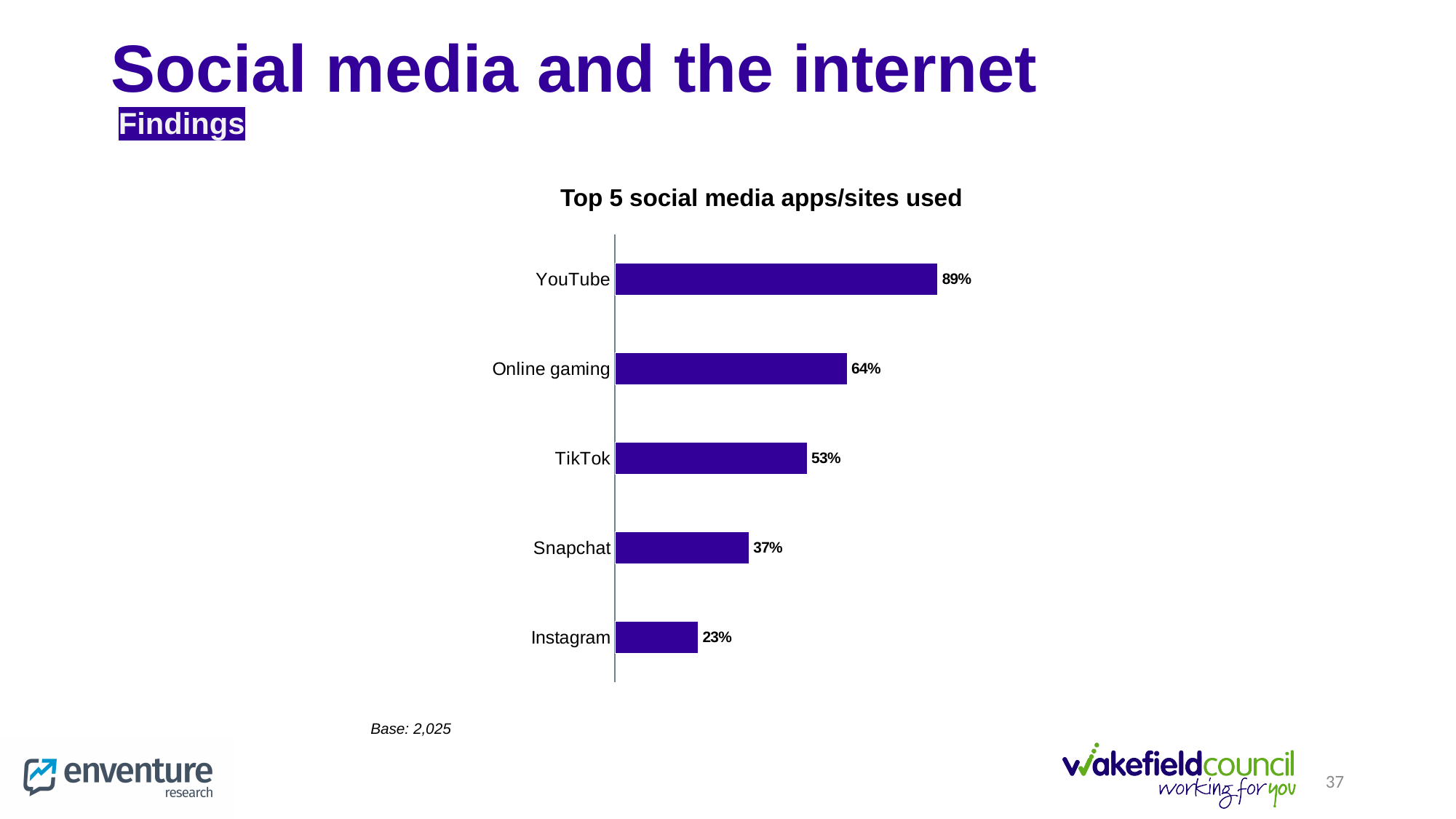
What is the difference in percentage points between YouTube and Online gaming? 25 What percentage is shown for TikTok? 53% What type of chart is used on this slide? Bar chart How many apps/sites are shown in the chart? 5 What is the title of the chart? Top 5 social media apps/sites used What is the value for Instagram? 23% Which app/site has the highest percentage of use? YouTube What is the value shown for Online gaming? 64% Which app/site has the lowest percentage of use? Instagram Which has a higher value, TikTok or Snapchat? TikTok What is the difference in percentage points between Snapchat and Instagram? 14 What percentage of respondents use YouTube? 89%